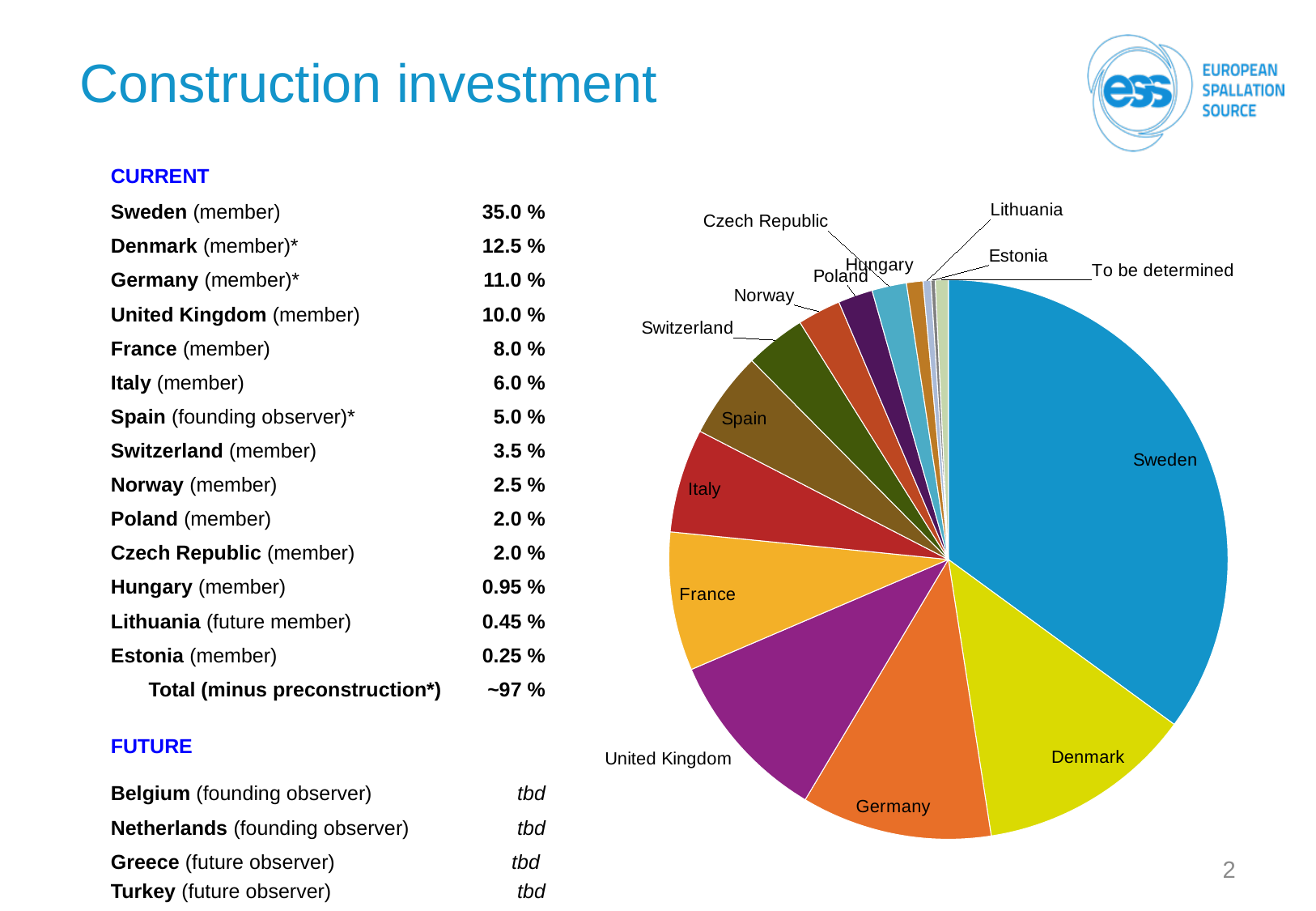
Which slice of the pie chart is the largest? Sweden What is the value shown for Switzerland? 3.5 % What is the title of the slide containing the pie chart? Construction investment What is the difference between Sweden's share and Denmark's share? 22.5 % What kind of chart is shown on the slide? pie chart Which slice is larger in the pie chart, France or Italy? France What share of construction investment does Sweden hold according to the slide? 35.0 % What is the difference between Germany's share and the United Kingdom's share? 1.0 % Which slice is larger in the pie chart, Sweden or Denmark? Sweden What is the value shown for the United Kingdom? 10.0 % What share of construction investment does Denmark hold according to the slide? 12.5 % How many slices does the pie chart have? 15